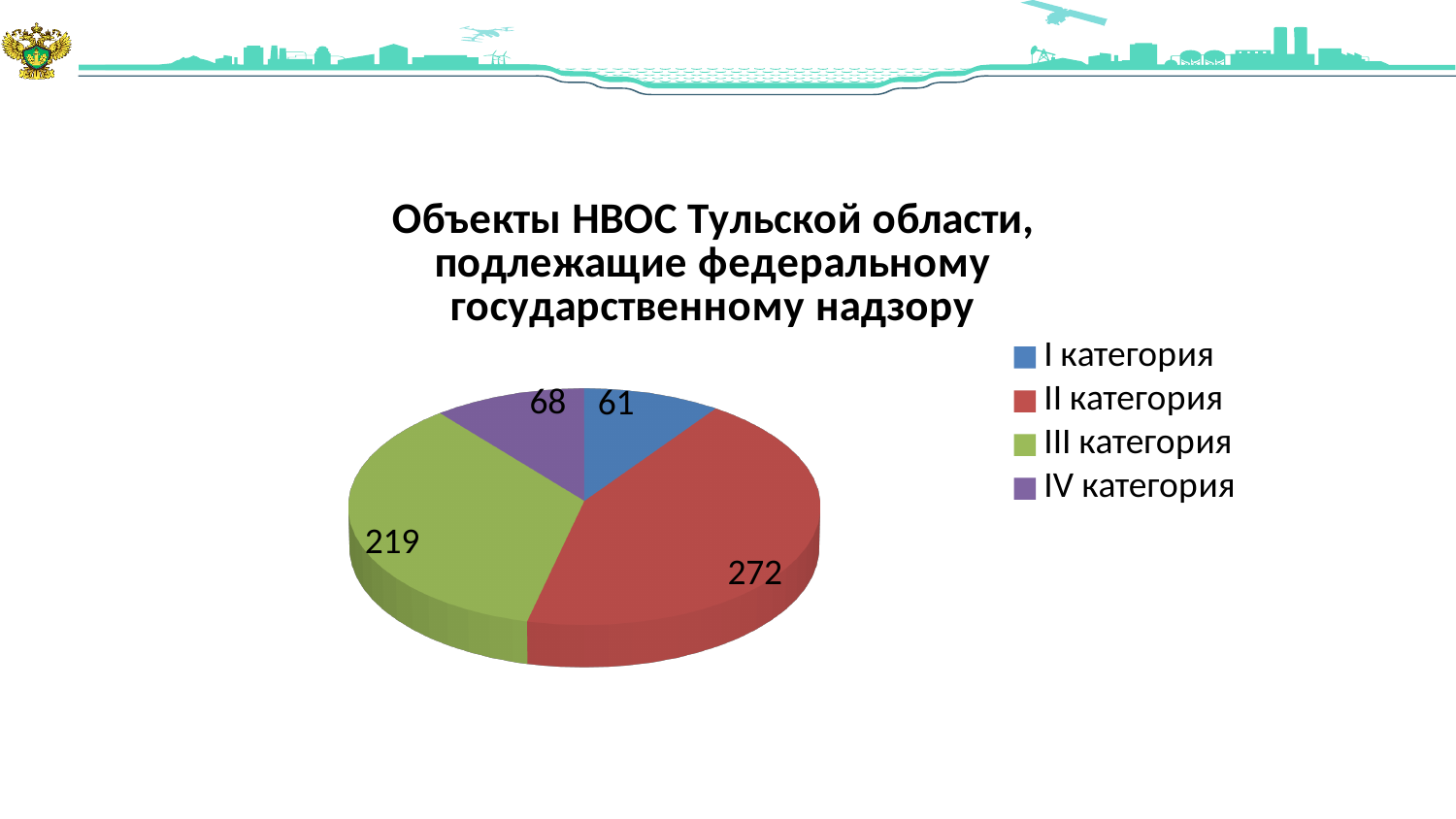
Which category has the largest slice? II категория What is the value for I категория? 61 What is the value for II категория? 272 What is the total of all slices in the pie chart? 620 What is the value for IV категория? 68 What type of chart is shown on the slide? Pie chart Which category has the smallest slice? I категория What is the title of the chart? Объекты НВОС Тульской области, подлежащие федеральному государственному надзору What is the value for III категория? 219 What is the difference between the values for II категория and III категория? 53 How many categories does the pie chart have? 4 Which is larger, the value for IV категория or the value for I категория? IV категория